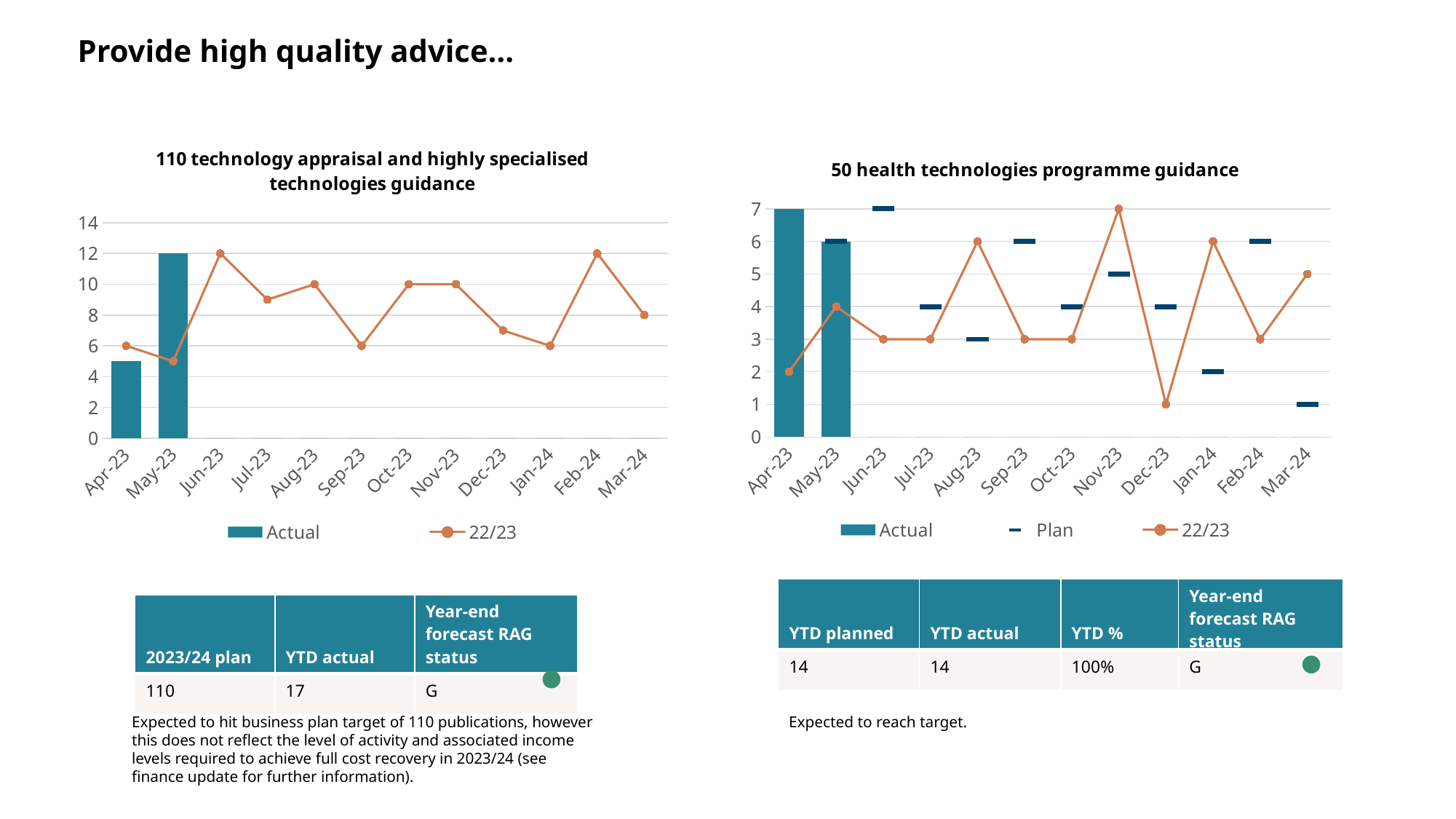
On the '50 health technologies programme guidance' chart, in which month does the 22/23 line reach its highest value? Nov-23 On the '110 technology appraisal and highly specialised technologies guidance' chart, what is the Actual value for May-23? 12 On the '50 health technologies programme guidance' chart, what is the Plan value for Mar-24? 1 On the '50 health technologies programme guidance' chart, in which month is the 22/23 line at its lowest value? Dec-23 On the '50 health technologies programme guidance' chart, what is the Actual value for May-23? 6 On the '110 technology appraisal and highly specialised technologies guidance' chart, how many months are shown on the x axis? 12 On the '110 technology appraisal and highly specialised technologies guidance' chart, which month has the larger Actual bar, Apr-23 or May-23? May-23 On the '110 technology appraisal and highly specialised technologies guidance' chart, what is the difference between the 22/23 values for Jun-23 and Sep-23? 6 On the '110 technology appraisal and highly specialised technologies guidance' chart, is the Actual value for Apr-23 greater or less than 4? greater On the '50 health technologies programme guidance' chart, how many series does the legend list? 3